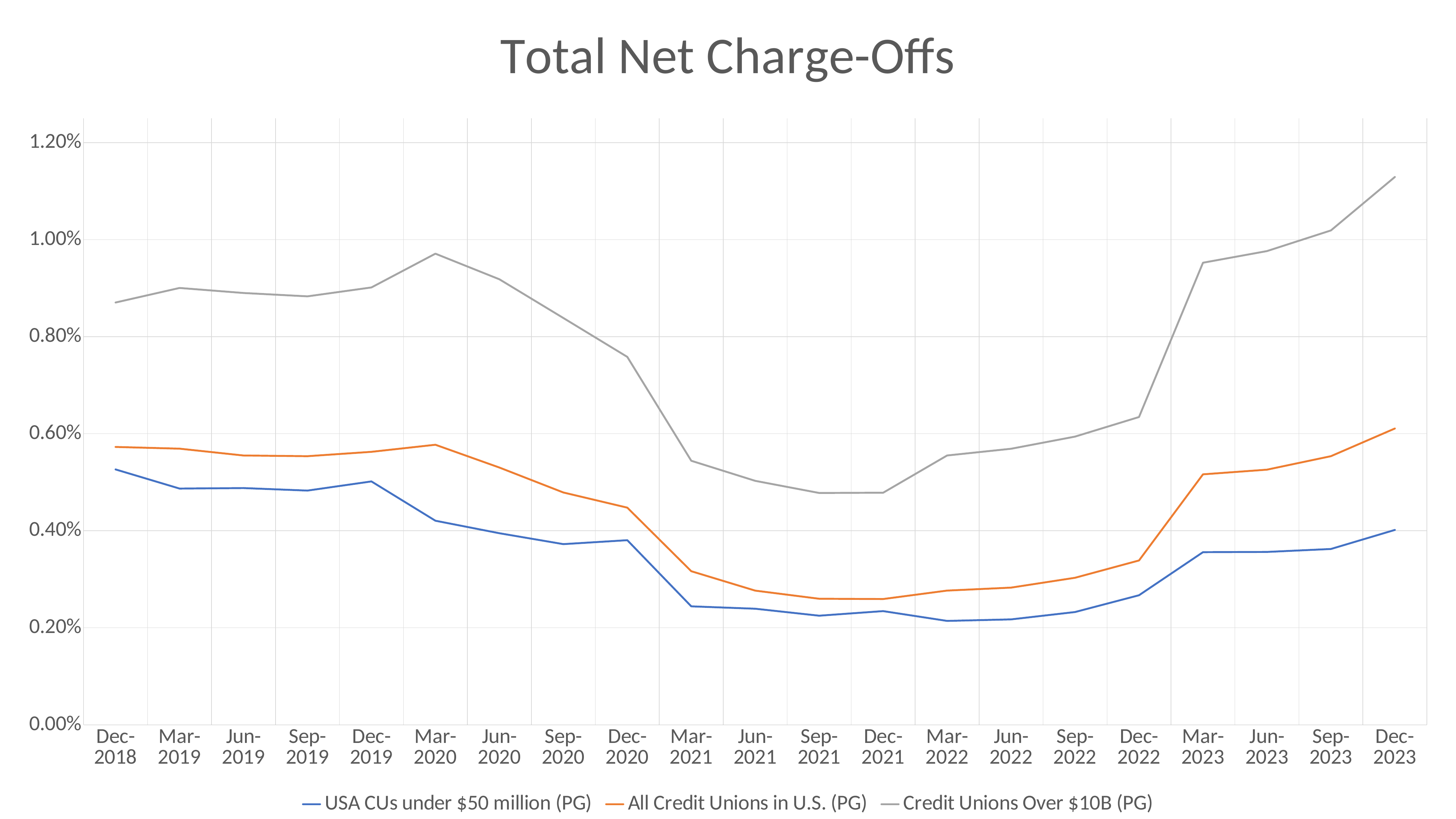
For Credit Unions Over $10B (PG), which is larger: the value at Dec-2018 or the value at Dec-2023? Dec-2023 Is the value for Credit Unions Over $10B (PG) at Mar-2020 greater or less than 1.00%? less What is the title of the chart? Total Net Charge-Offs What kind of chart is shown on the slide? line chart How many series does the legend list? 3 Is the value for USA CUs under $50 million (PG) at Dec-2018 greater or less than 0.40%? greater Does the Credit Unions Over $10B (PG) series rise or fall from Dec-2022 to Dec-2023? rise Is the value for USA CUs under $50 million (PG) at Mar-2021 greater or less than 0.40%? less At which date does the Credit Unions Over $10B (PG) series reach its highest value? Dec-2023 Which series is drawn in orange? All Credit Unions in U.S. (PG) How many points are plotted along the x axis for each series? 21